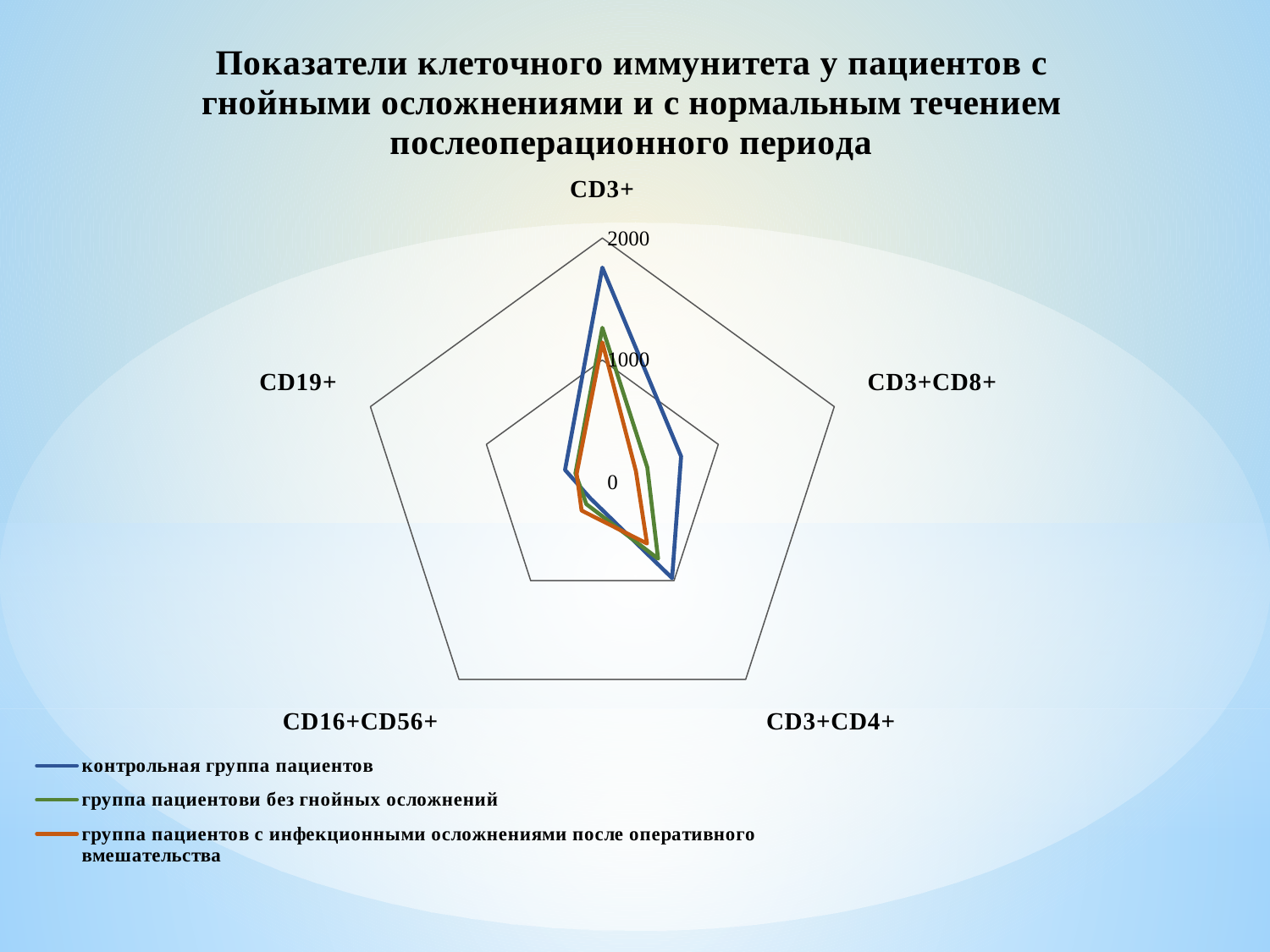
Is the CD3+ value for the group without purulent complications (группа пациентов без гнойных осложнений) greater or less than 1000? greater Is the CD3+ value for the control group (контрольная группа пациентов) greater or less than 1000? greater Is the CD3+CD8+ value for the group with infectious complications after surgery greater or less than 1000? less How many axes (categories) does the radar chart have? 5 Which series is drawn in orange in the legend? группа пациентов с инфекционными осложнениями после оперативного вмешательства Which series has the higher CD3+CD8+ value: the control group or the group with infectious complications after surgery? контрольная группа пациентов What kind of chart is shown on the slide? radar chart Which series has the higher CD3+ value: the control group or the group without purulent complications? контрольная группа пациентов How many series does the legend list? 3 What is the highest value shown on the radial axis scale? 2000 Which category has the highest value for the control group (контрольная группа пациентов)? CD3+